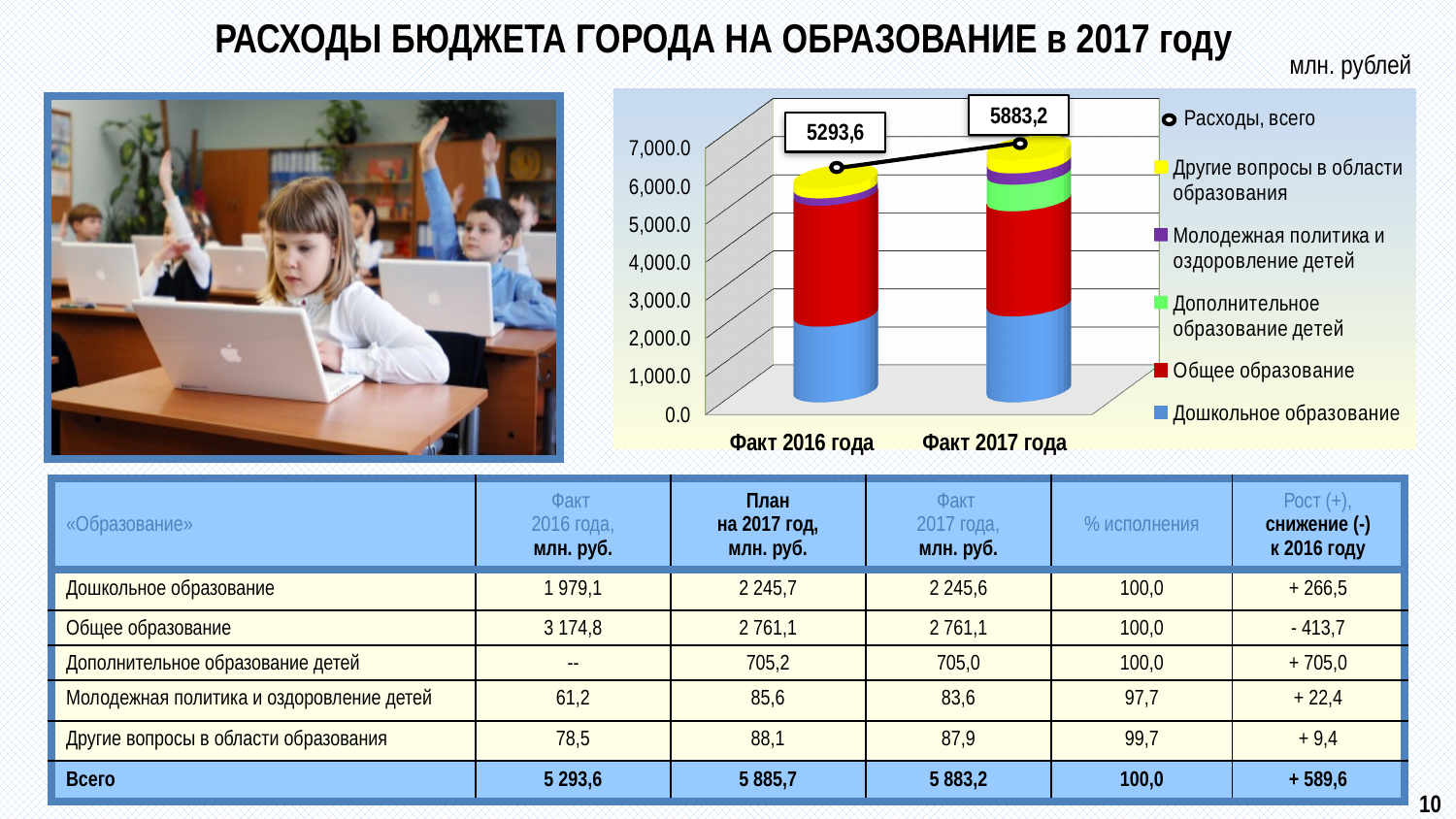
What is the difference between Расходы, всего for Факт 2017 года and Факт 2016 года? 589,6 Is the value of Расходы, всего for Факт 2016 года greater or less than 5,000.0? greater How many series does the chart legend list? 6 How many categories are shown on the x axis of the chart? 2 Which series forms the bottom segment of each stacked bar? Дошкольное образование Do the values of Расходы, всего rise or fall from Факт 2016 года to Факт 2017 года? rise What is the value of Расходы, всего for Факт 2016 года? 5293,6 What is the value of Расходы, всего for Факт 2017 года? 5883,2 What colour represents Общее образование in the chart? red Is the Дошкольное образование segment for Факт 2017 года greater or less than 2,000.0? greater What kind of chart is shown on the slide? bar chart Which category has the higher value of Расходы, всего: Факт 2016 года or Факт 2017 года? Факт 2017 года